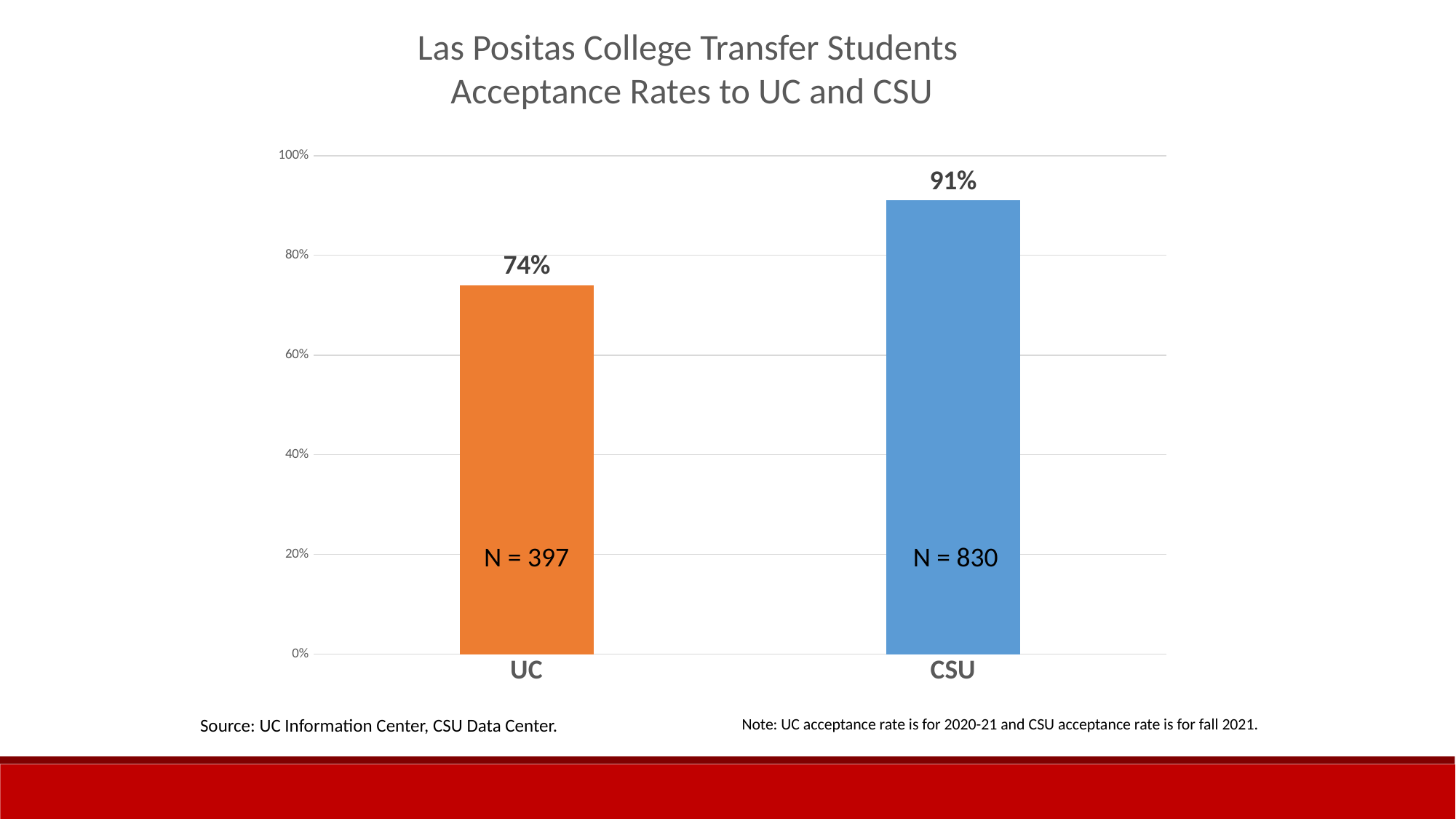
What is the difference in percentage points between the CSU and UC acceptance rates? 17 What is the acceptance rate for UC? 74% Which category has the lowest acceptance rate? UC What is the acceptance rate for CSU? 91% What is the N value shown on the UC bar? N = 397 Is the value for UC greater or less than 80%? less Is the acceptance rate higher for UC or for CSU? CSU What kind of chart is shown on the slide? Bar chart Is the value for CSU greater or less than 80%? greater How many categories are shown on the chart? 2 Which category has the highest acceptance rate? CSU What is the title of the chart? Las Positas College Transfer Students Acceptance Rates to UC and CSU